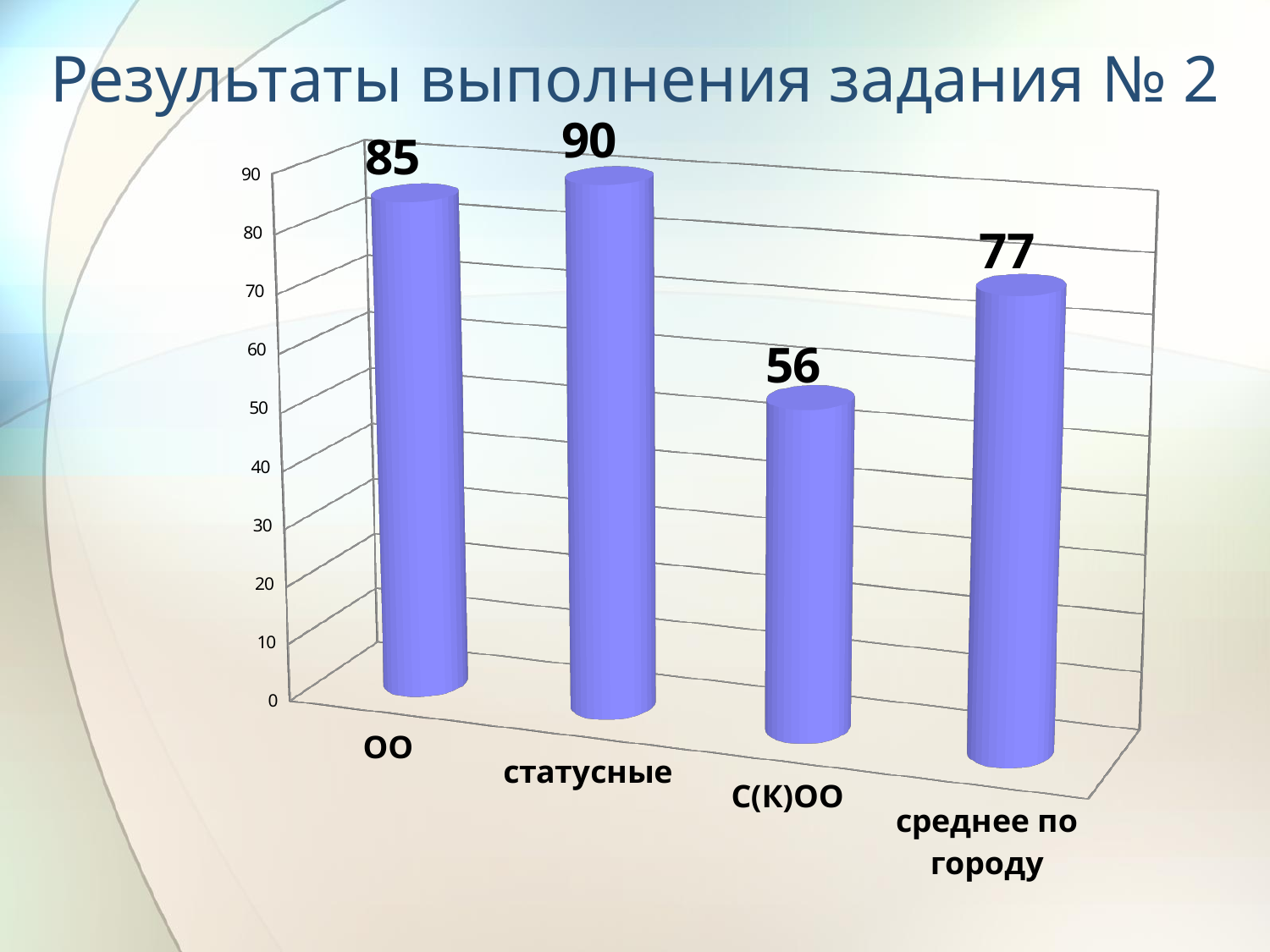
Which category has the lowest value? С(К)ОО What is the value for среднее по городу? 77 What is the value for статусные? 90 How many categories are shown in the chart? 4 Which category has the highest value? статусные Which is larger, the value for ОО or the value for среднее по городу? ОО What is the value for ОО? 85 What is the title of the slide? Результаты выполнения задания № 2 What is the difference between the values for статусные and С(К)ОО? 34 What is the difference between the values for ОО and среднее по городу? 8 What kind of chart is shown on the slide? bar chart What is the value for С(К)ОО? 56